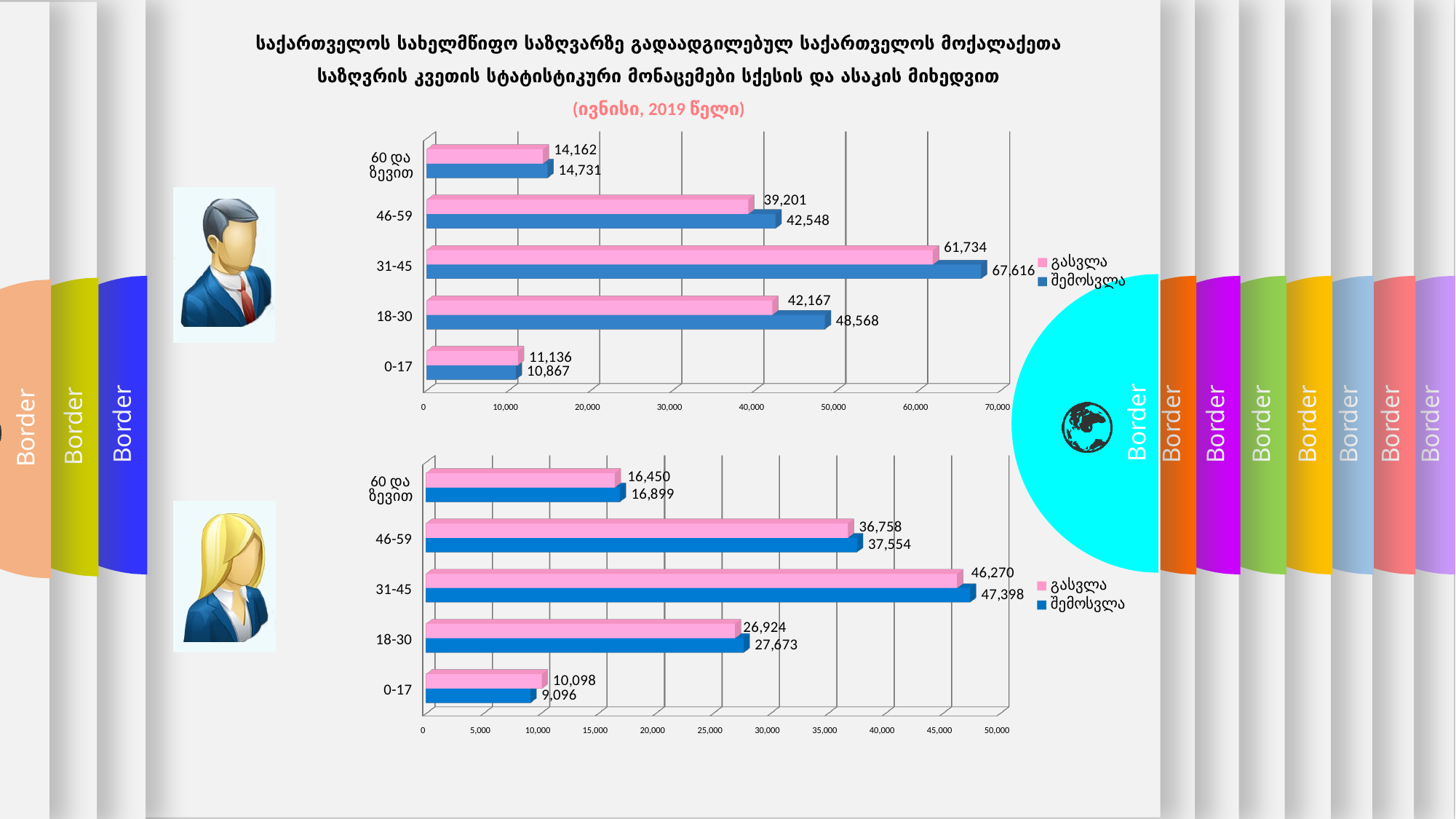
In the top chart, what is the difference between შემოსვლა and გასვლა for the 31-45 age group? 5,882 In the top chart, is the შემოსვლა value for the 18-30 age group greater or less than 40,000? greater In the top chart, which age group has the highest შემოსვლა value? 31-45 In the bottom chart, how much larger is გასვლა than შემოსვლა for the 0-17 age group? 1,002 How many series does the legend of the top chart list? 2 How many age groups are shown in the bottom chart? 5 In the bottom chart, what is the value of გასვლა for the 18-30 age group? 26,924 What type of chart is the top chart? bar chart In the top chart, what is the value of შემოსვლა for the 31-45 age group? 67,616 In the bottom chart, what is the value of შემოსვლა for the 46-59 age group? 37,554 In the bottom chart, which age group has the lowest გასვლა value? 0-17 In the top chart, for the 0-17 age group, which is larger: გასვლა or შემოსვლა? გასვლა